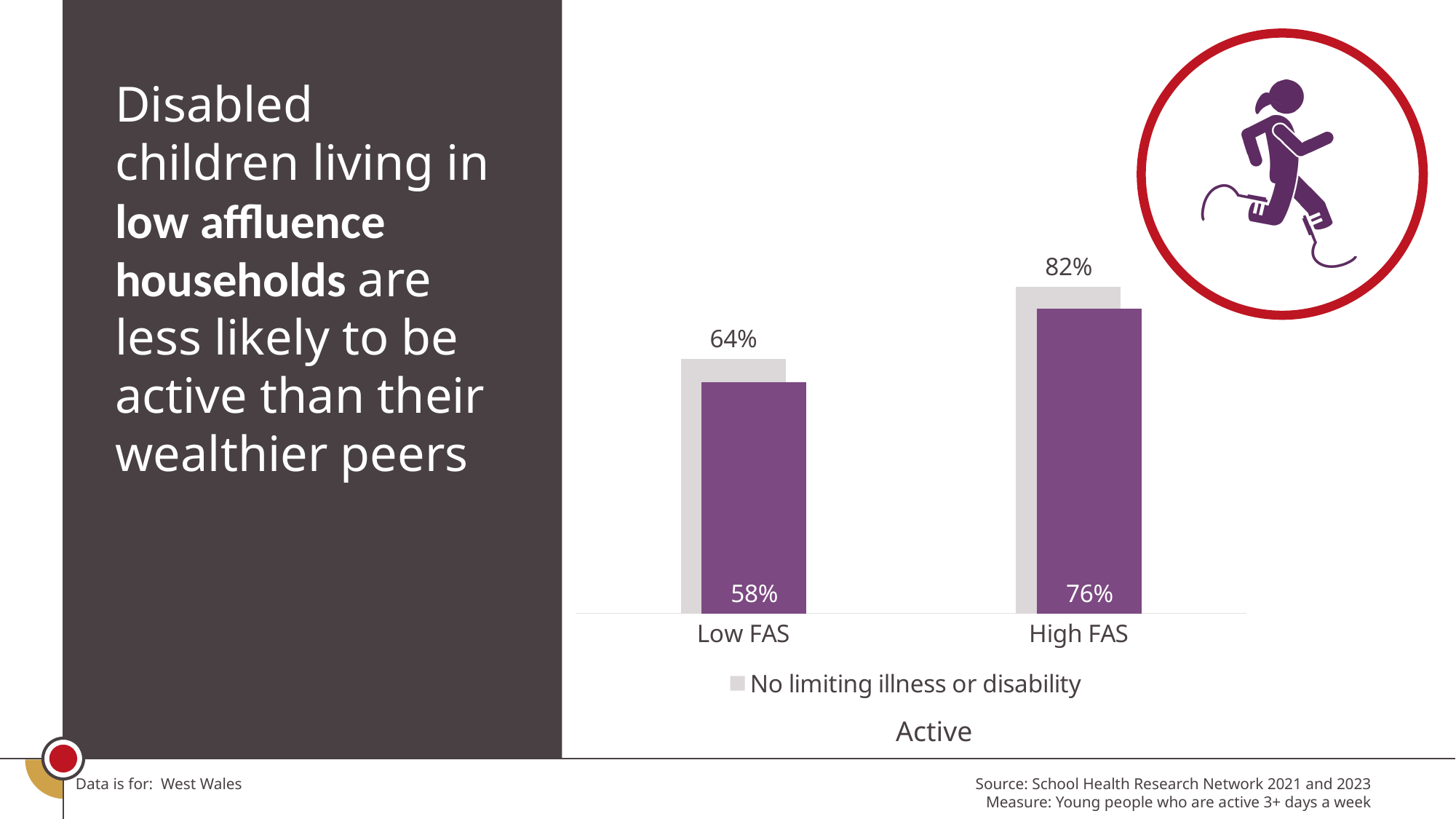
What is the title of the chart? Active Which category has the higher value for No limiting illness or disability, Low FAS or High FAS? High FAS What is the value for No limiting illness or disability in the Low FAS category? 64% What value is shown on the purple bar for High FAS? 76% How many categories are shown on the x axis of the chart? 2 What kind of chart is shown on the slide? Bar chart What is the difference between the No limiting illness or disability values for High FAS and Low FAS? 18 percentage points Which category has the lowest purple bar value? Low FAS What is the value for No limiting illness or disability in the High FAS category? 82% What value is shown on the purple bar for Low FAS? 58% In the High FAS category, what is the difference between the grey bar (82%) and the purple bar (76%)? 6 percentage points In the Low FAS category, what is the difference between the grey bar (64%) and the purple bar (58%)? 6 percentage points